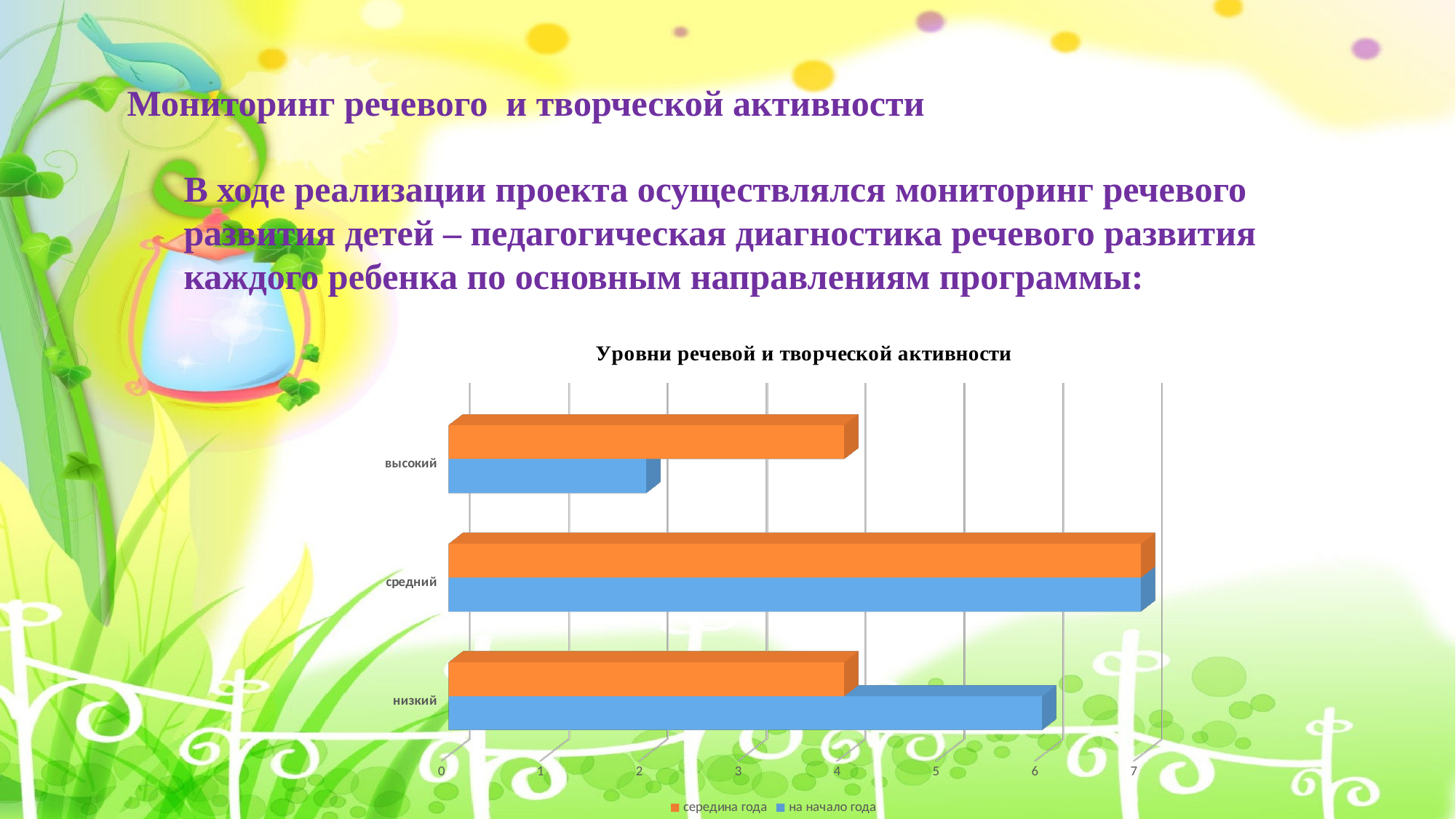
What is the title of the chart? Уровни речевой и творческой активности For the category "высокий", which series has the larger value: "середина года" or "на начало года"? середина года For the category "низкий", which series has the larger value: "середина года" or "на начало года"? на начало года What kind of chart is shown on the slide? bar chart Which colour represents the series "на начало года"? blue How many series does the chart legend list? 2 Which category has the lowest value in the series "на начало года"? высокий How many categories are shown on the chart? 3 Is the value for "средний" in the series "середина года" greater or less than 6? greater Is the value for "низкий" in the series "на начало года" greater or less than 5? greater Is the value for "высокий" in the series "середина года" greater or less than 3? greater